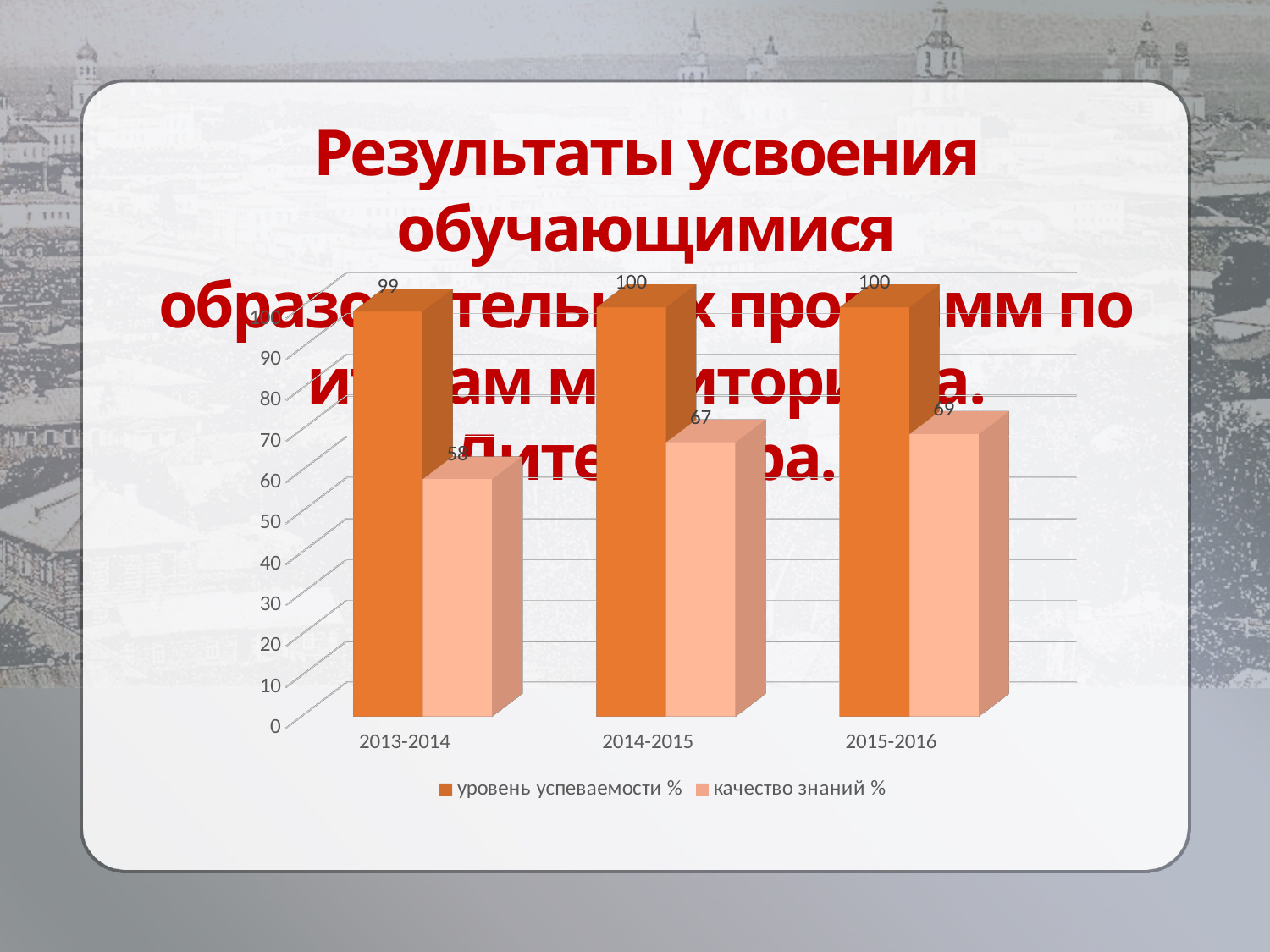
Does качество знаний % rise or fall from 2013-2014 to 2015-2016? Rises Which year has the higher value for качество знаний %: 2014-2015 or 2015-2016? 2015-2016 What is the value of качество знаний % for 2015-2016? 69 What is the value of качество знаний % for 2014-2015? 67 By how much did качество знаний % increase from 2013-2014 to 2015-2016? 11 Which year has the lowest value for качество знаний %? 2013-2014 How many series does the legend list? 2 How many academic years are shown on the x axis? 3 What is the difference between уровень успеваемости % and качество знаний % in 2015-2016? 31 What is the value of уровень успеваемости % for 2015-2016? 100 What kind of chart is shown on the slide? Bar chart What is the value of уровень успеваемости % for 2013-2014? 99